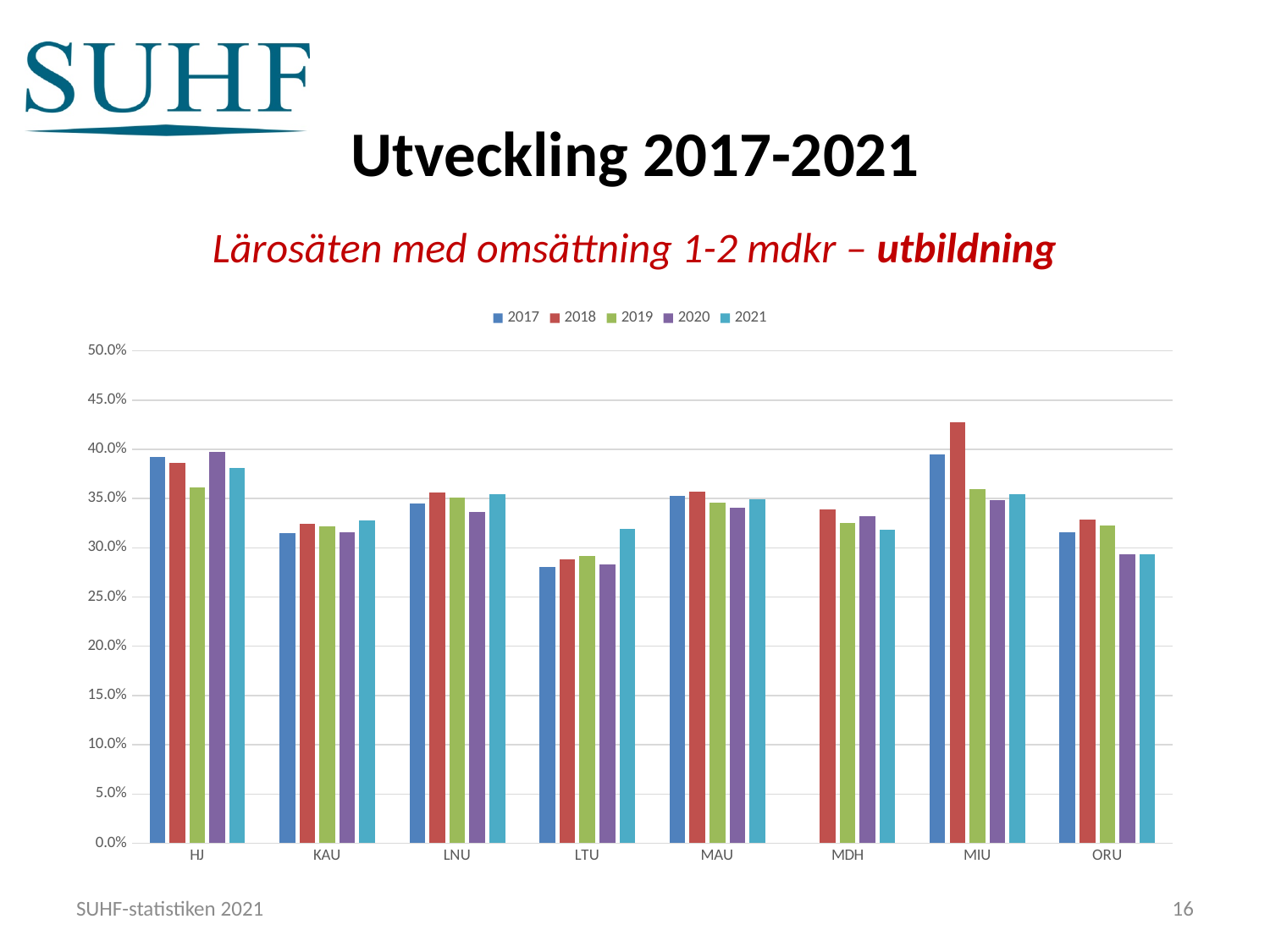
For MIU, which year has the highest bar? 2018 Is the value for MIU in 2018 greater or less than 40.0%? greater Which institution has no bar for 2017? MDH How many series does the legend list? 5 How many categories (institutions) are shown on the x axis? 8 Which institution has the lowest bar for 2017? LTU Is the value for LTU in 2017 greater or less than 30.0%? less For LTU, which year has the highest bar? 2021 Which is larger: the 2017 value for HJ or the 2017 value for KAU? HJ Is the value for HJ in 2017 greater or less than 35.0%? greater What kind of chart is shown on the slide? bar chart Which institution has the highest bar for 2018? MIU